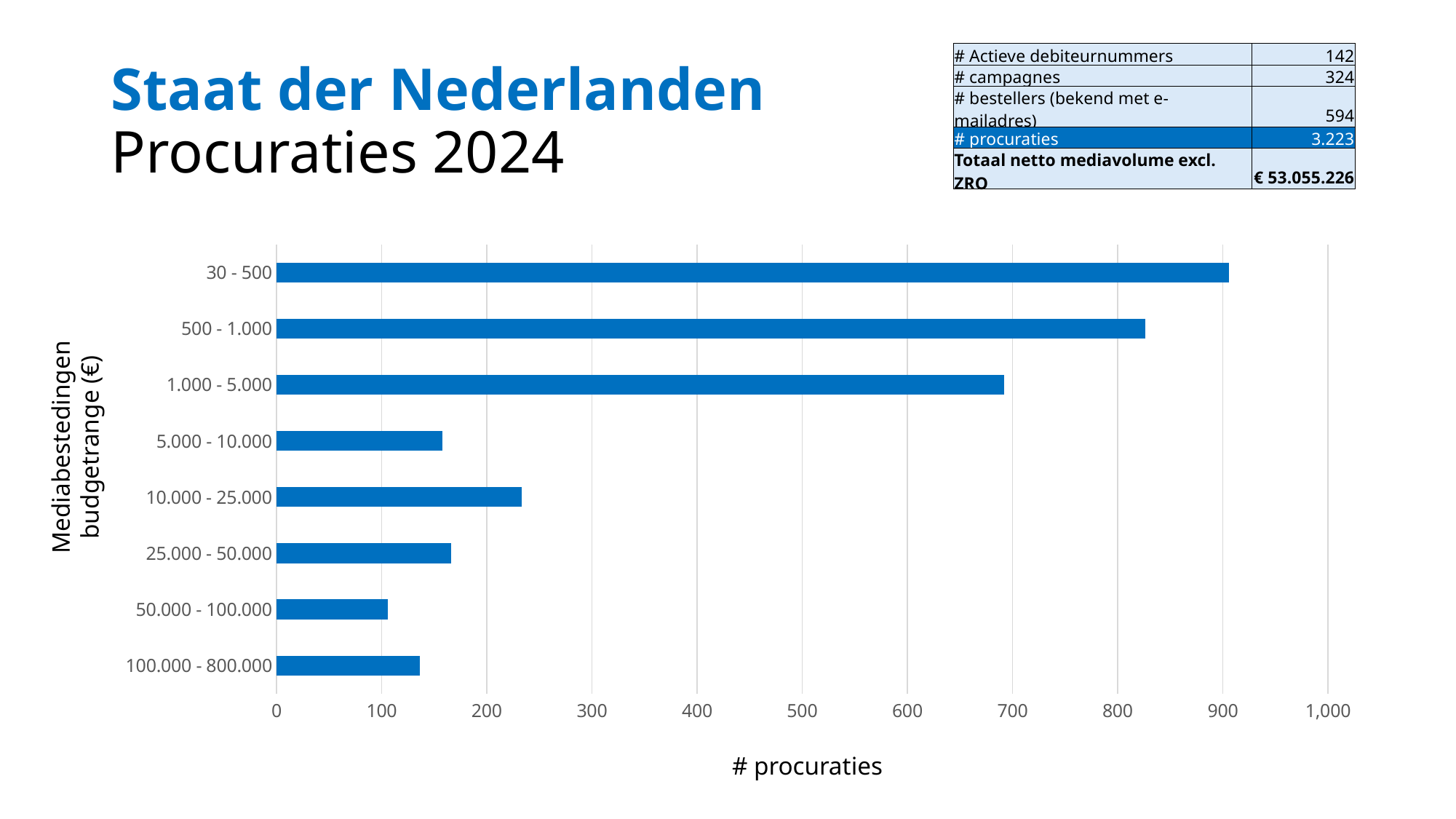
Is the value for 100.000 - 800.000 greater or less than 100? greater Which has more procuraties: 10.000 - 25.000 or 5.000 - 10.000? 10.000 - 25.000 Which has more procuraties: 500 - 1.000 or 1.000 - 5.000? 500 - 1.000 What is the title of the horizontal axis of the chart? # procuraties Which budget range has the lowest number of procuraties? 50.000 - 100.000 Is the value for 10.000 - 25.000 greater or less than 200? greater Is the value for 5.000 - 10.000 greater or less than 200? less Which budget range has the highest number of procuraties? 30 - 500 How many budget range categories are plotted in the chart? 8 What kind of chart is shown on the slide? bar chart